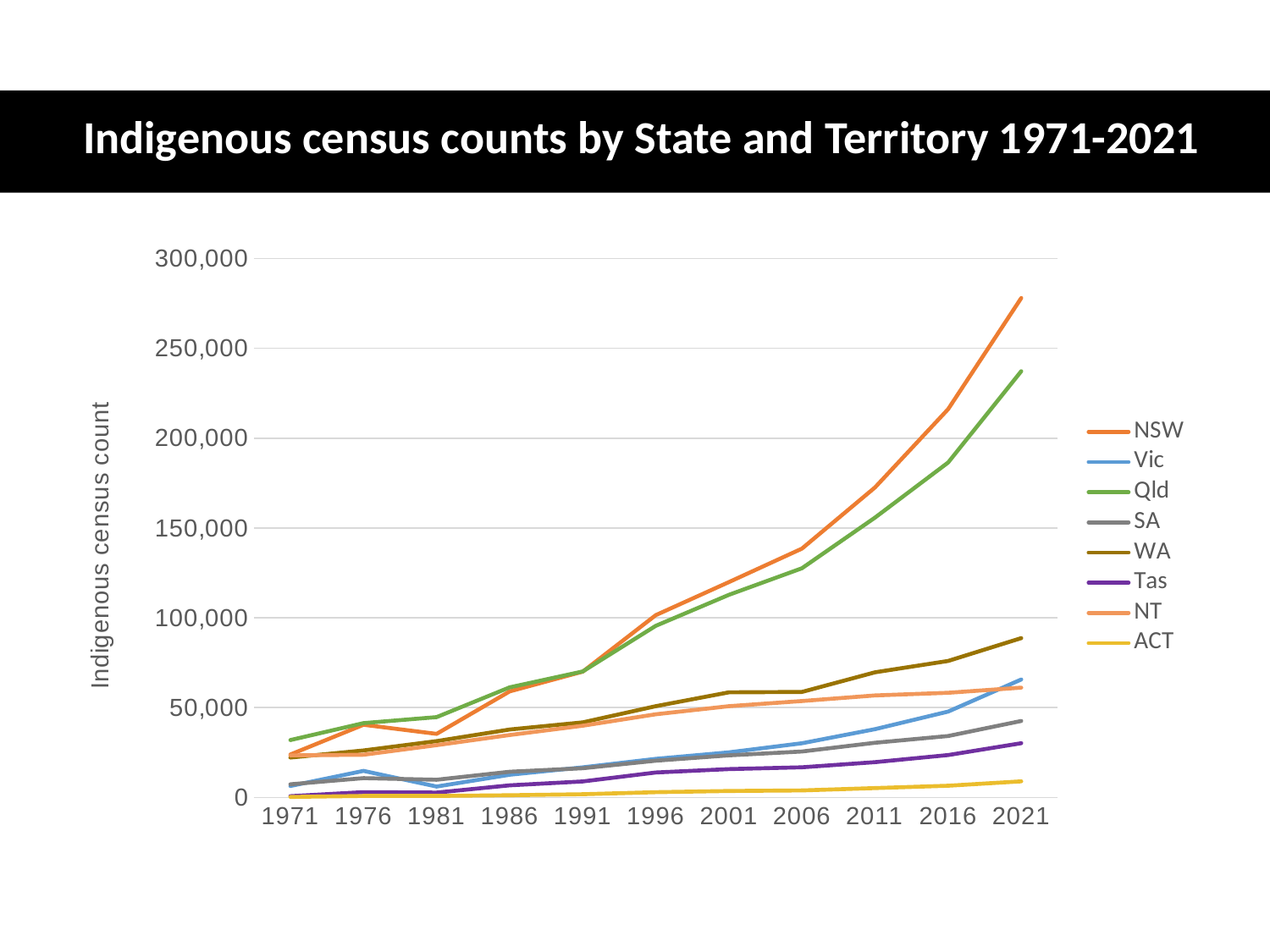
Which State or Territory has the highest Indigenous census count in 2021? NSW Is the value for Qld in 2021 greater or less than 250,000? less Which is larger in 2021, the count for NSW or the count for Qld? NSW Which State or Territory has the lowest Indigenous census count in 2021? ACT How many census years are shown along the x axis? 11 Is the value for NSW in 2021 greater or less than 250,000? greater What kind of chart is shown on the slide? Line chart Which is larger in 2021, the count for Vic or the count for SA? Vic Is the value for WA in 2021 greater or less than 100,000? less Does the NSW line rise or fall from 1971 to 2021? Rises How many series does the legend list? 8 What is the label on the vertical axis? Indigenous census count